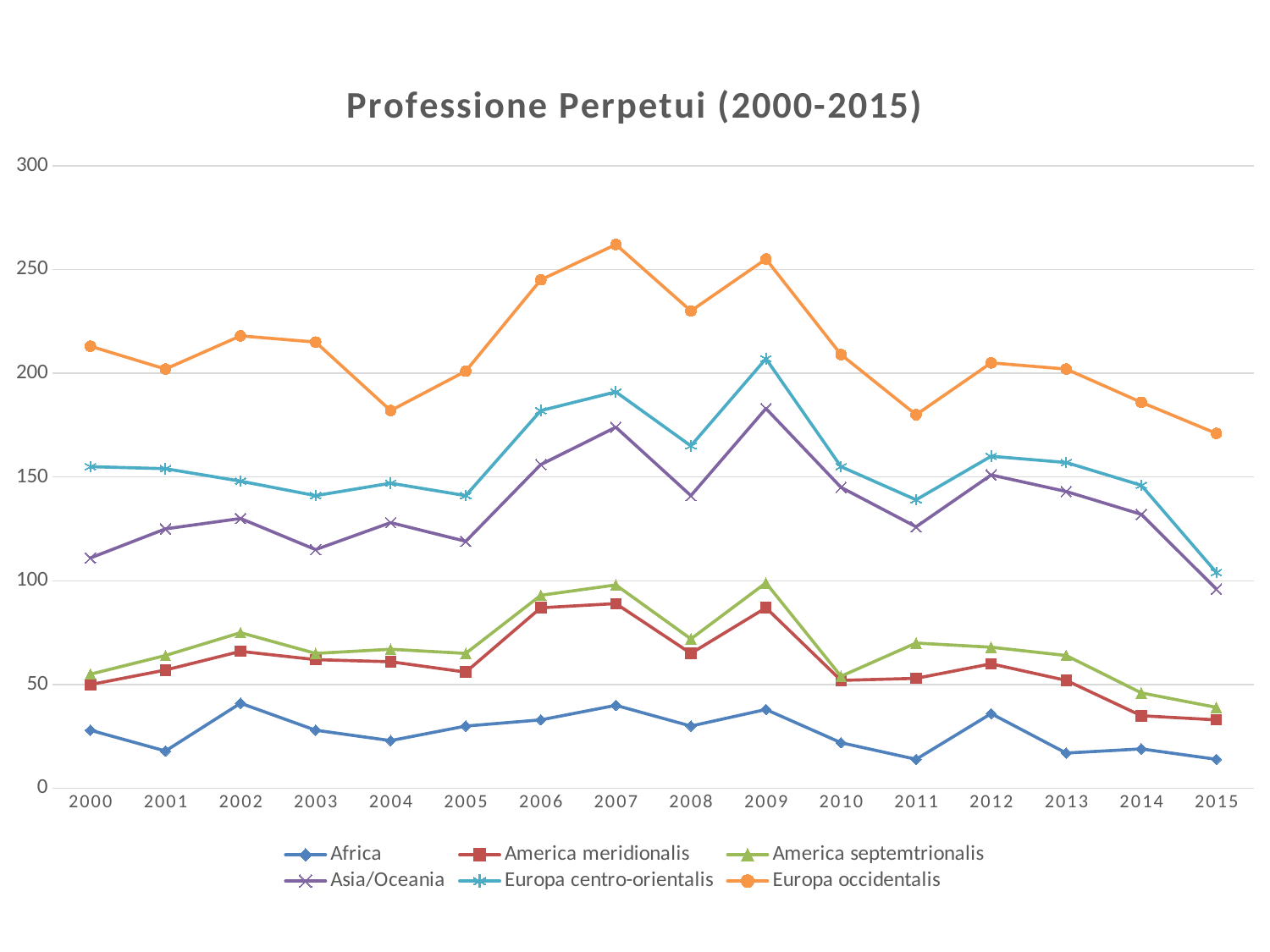
In which year does the Europa centro-orientalis series reach its lowest value? 2015 How many series does the legend list? 6 In which year does the Europa occidentalis series reach its lowest value? 2015 Which series has the higher value in 2000, Europa occidentalis or Europa centro-orientalis? Europa occidentalis Is the value for Europa occidentalis in 2007 greater or less than 250? greater In which year does the Europa centro-orientalis series reach its highest value? 2009 Is the value for Europa centro-orientalis in 2009 greater or less than 200? greater In which year does the Asia/Oceania series reach its highest value? 2009 Is the value for Africa in 2011 greater or less than 50? less How many years are plotted along the x axis? 16 What kind of chart is shown on the slide? line chart What is the title of the chart? Professione Perpetui (2000-2015)